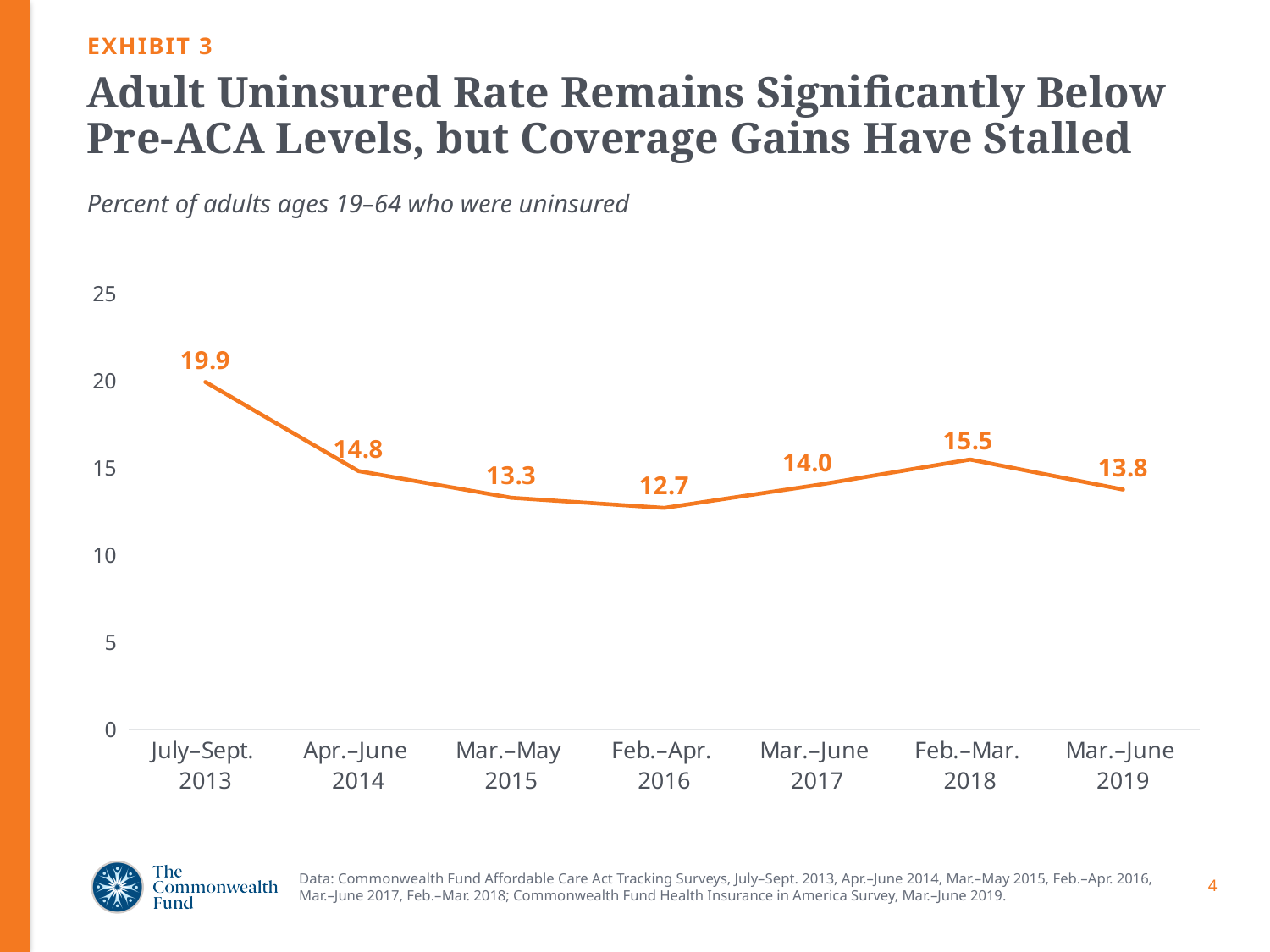
What is the difference between the uninsured rate in Feb.–Mar. 2018 and Mar.–June 2017? 1.5 What was the percent of adults ages 19–64 who were uninsured in July–Sept. 2013? 19.9 Which survey period has the lowest uninsured rate? Feb.–Apr. 2016 What is the difference between the uninsured rate in July–Sept. 2013 and Mar.–June 2019? 6.1 Which survey period has the highest uninsured rate? July–Sept. 2013 What was the uninsured rate in Feb.–Apr. 2016? 12.7 What was the uninsured rate in Mar.–June 2019? 13.8 Is the uninsured rate in Mar.–May 2015 greater or less than 15? less Does the uninsured rate rise or fall from July–Sept. 2013 to Feb.–Apr. 2016? fall What kind of chart is shown on the slide? line chart Which is larger, the uninsured rate in Apr.–June 2014 or in Feb.–Mar. 2018? Feb.–Mar. 2018 How many survey periods are plotted on the chart? 7